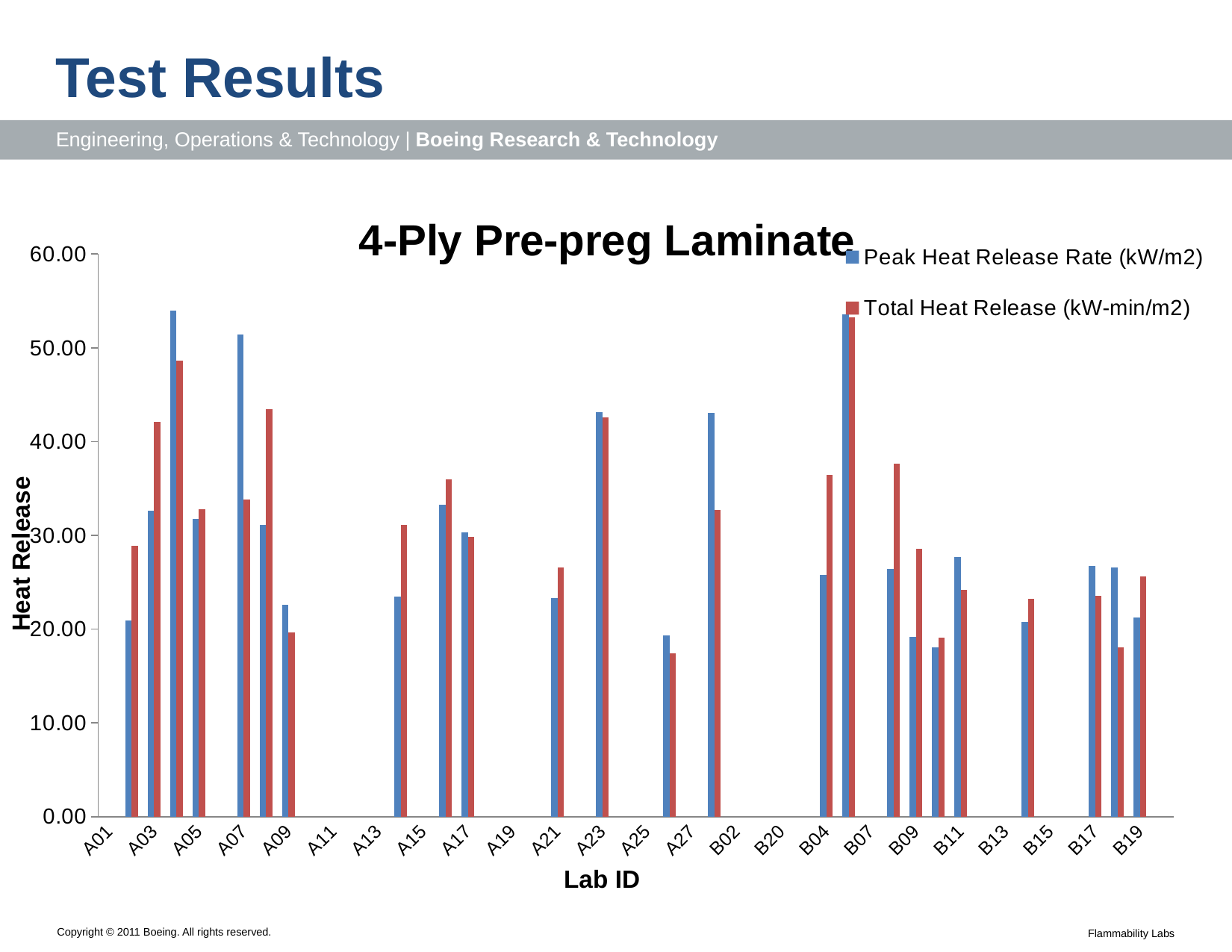
Is the tallest Peak Heat Release Rate (kW/m2) bar greater or less than 50? greater What kind of chart is shown on the slide? bar chart What is the highest value shown on the y axis? 60.00 How many series does the legend list? 2 What is the label on the x axis of the chart? Lab ID Do any bars in the chart reach the 60.00 line on the y axis? No Which series is shown in blue in the legend? Peak Heat Release Rate (kW/m2) How many Lab ID labels are printed along the x axis? 24 Is the tallest Total Heat Release (kW-min/m2) bar greater or less than 50? greater